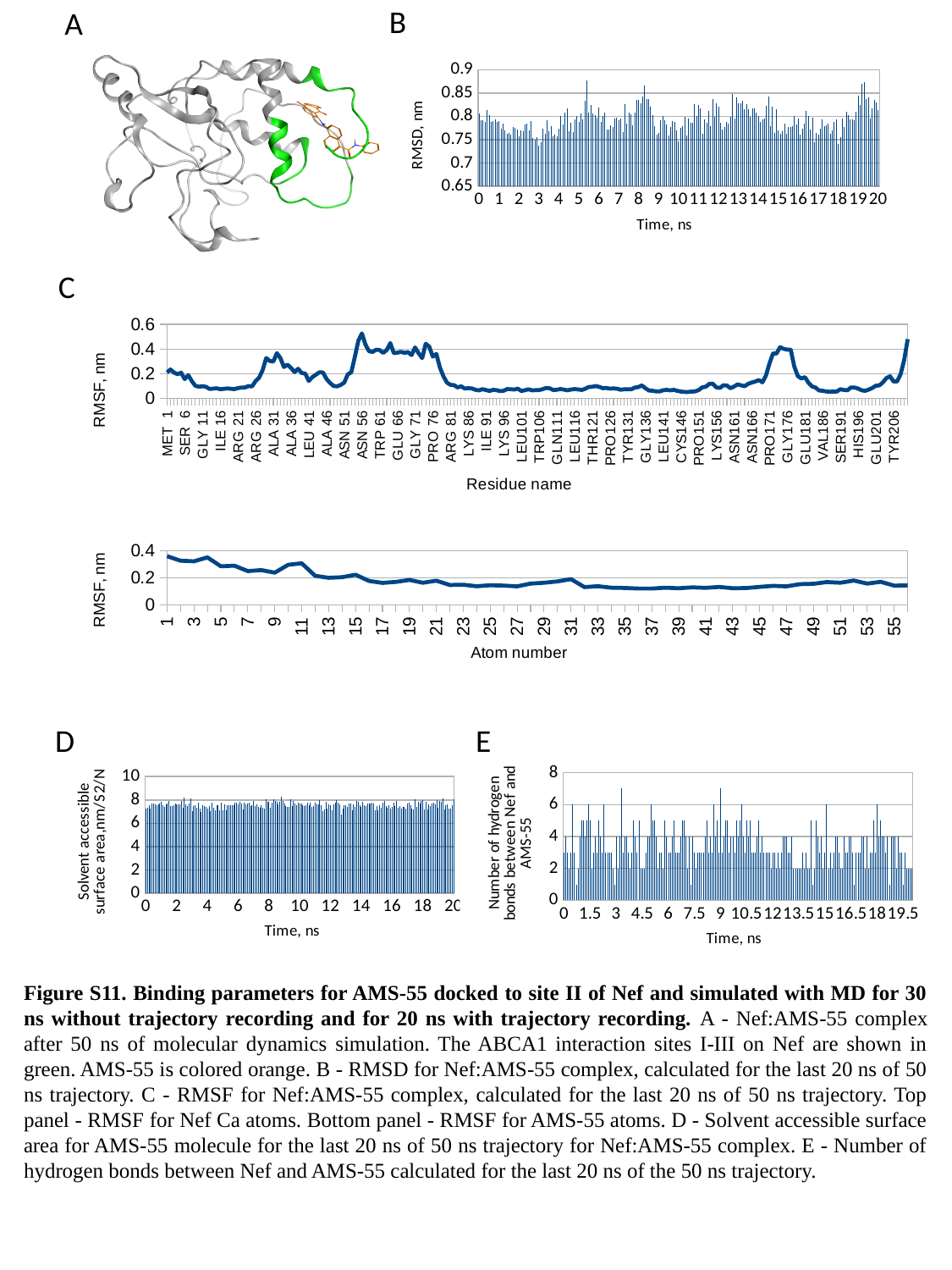
In the top panel of C, is the RMSF value at ASN 56 greater or less than 0.4? greater In the bottom panel of C, is the RMSF value at atom number 1 greater or less than 0.3? greater In panel B, is the RMSD value at 0 ns greater or less than 0.75? greater What kind of chart is panel B (RMSD vs time)? bar chart In the bottom panel of C, do the RMSF values generally rise or fall as the atom number increases? fall What kind of chart is the top panel of C (RMSF vs residue name)? line chart What is the y-axis label of the chart in panel B? RMSD, nm What is the x-axis label of the bottom panel of C? Atom number